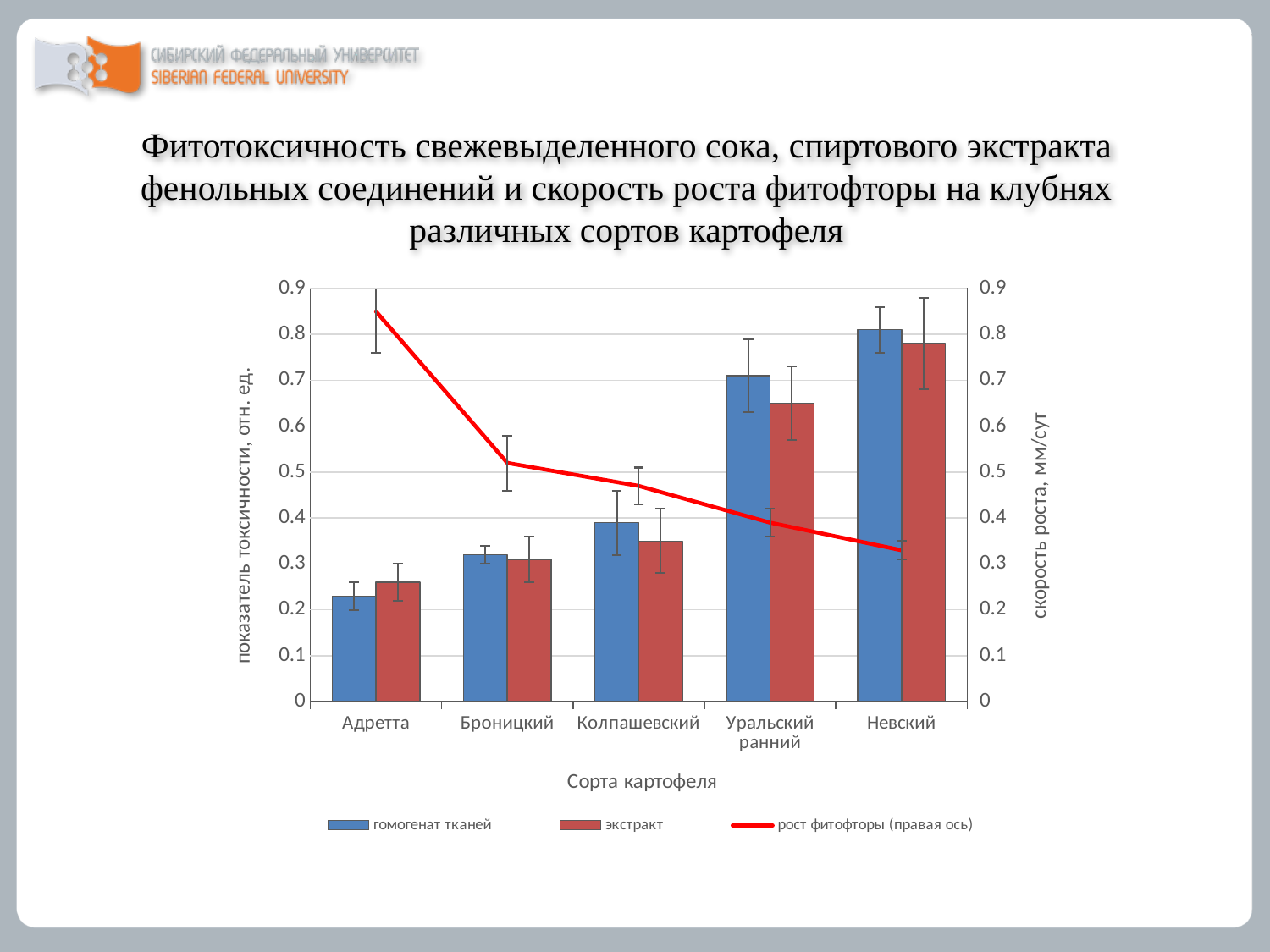
For Уральский ранний, which is larger: гомогенат тканей or экстракт? гомогенат тканей Is the value for гомогенат тканей for Уральский ранний greater or less than 0.6? greater Which variety has the highest value on the рост фитофторы line? Адретта Does the рост фитофторы line rise or fall from Адретта to Невский? Fall Which variety has the highest value for гомогенат тканей? Невский What is the label of the right-hand vertical axis? скорость роста, мм/сут Is the value for гомогенат тканей for Адретта greater or less than 0.3? less How many potato varieties (categories) are shown on the x axis? 5 Is the рост фитофторы value for Невский greater or less than 0.4? less How many series does the legend list? 3 What kind of chart is shown on the slide? Combined bar and line chart Which variety has the lowest value for гомогенат тканей? Адретта